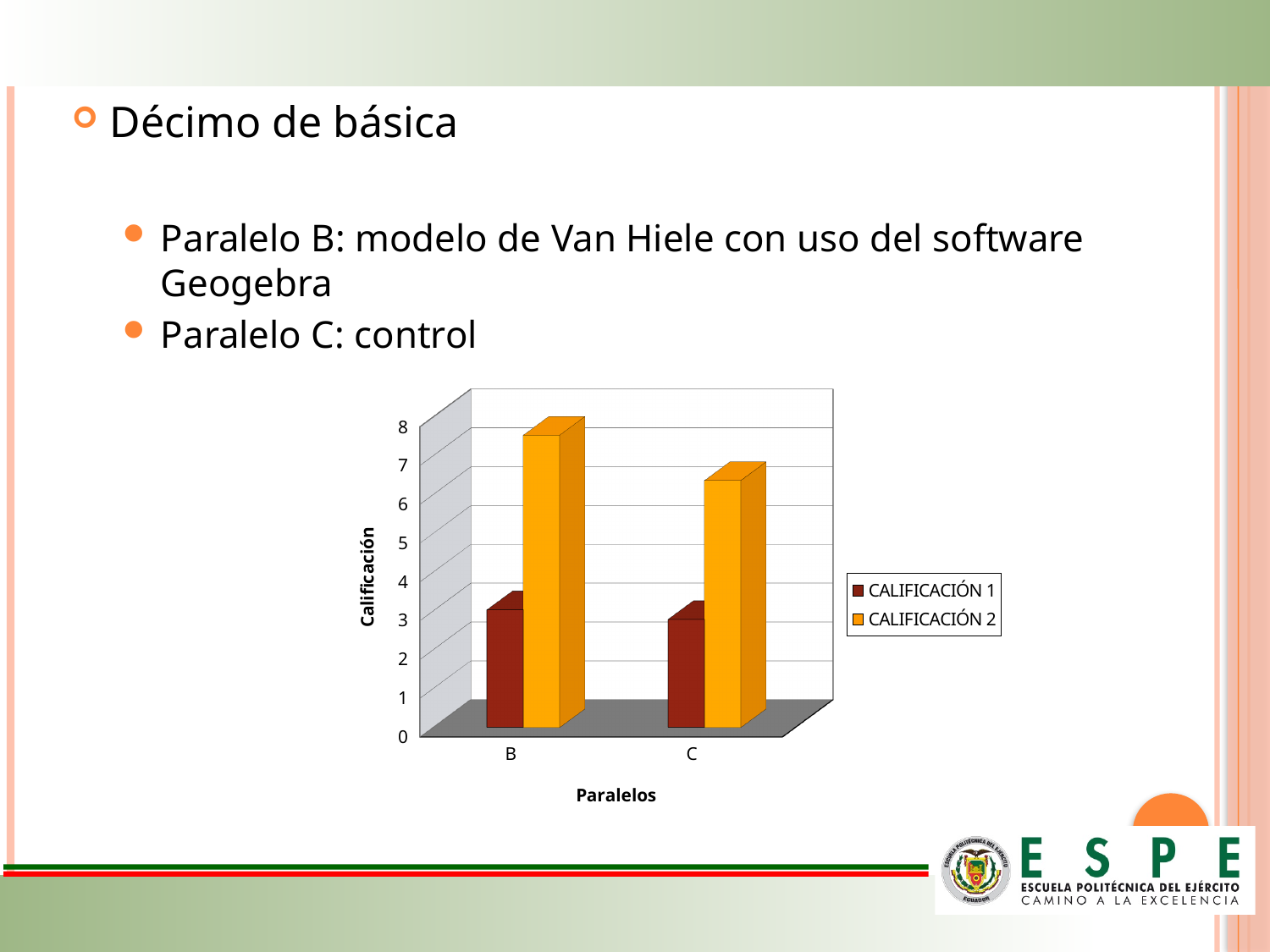
How many series does the chart's legend list? 2 What is the title of the chart's vertical axis? Calificación Is the CALIFICACIÓN 2 value for paralelo C greater or less than 6? greater How many categories are shown on the x axis of the chart? 2 What kind of chart is shown on the slide? bar chart Is the CALIFICACIÓN 2 value for paralelo C greater or less than 7? less What are the names of the series listed in the chart's legend? CALIFICACIÓN 1 and CALIFICACIÓN 2 Is the CALIFICACIÓN 1 value for paralelo C greater or less than 2? greater Which paralelo has the higher CALIFICACIÓN 2 value, B or C? B Which bar in the chart is the tallest? CALIFICACIÓN 2 for B